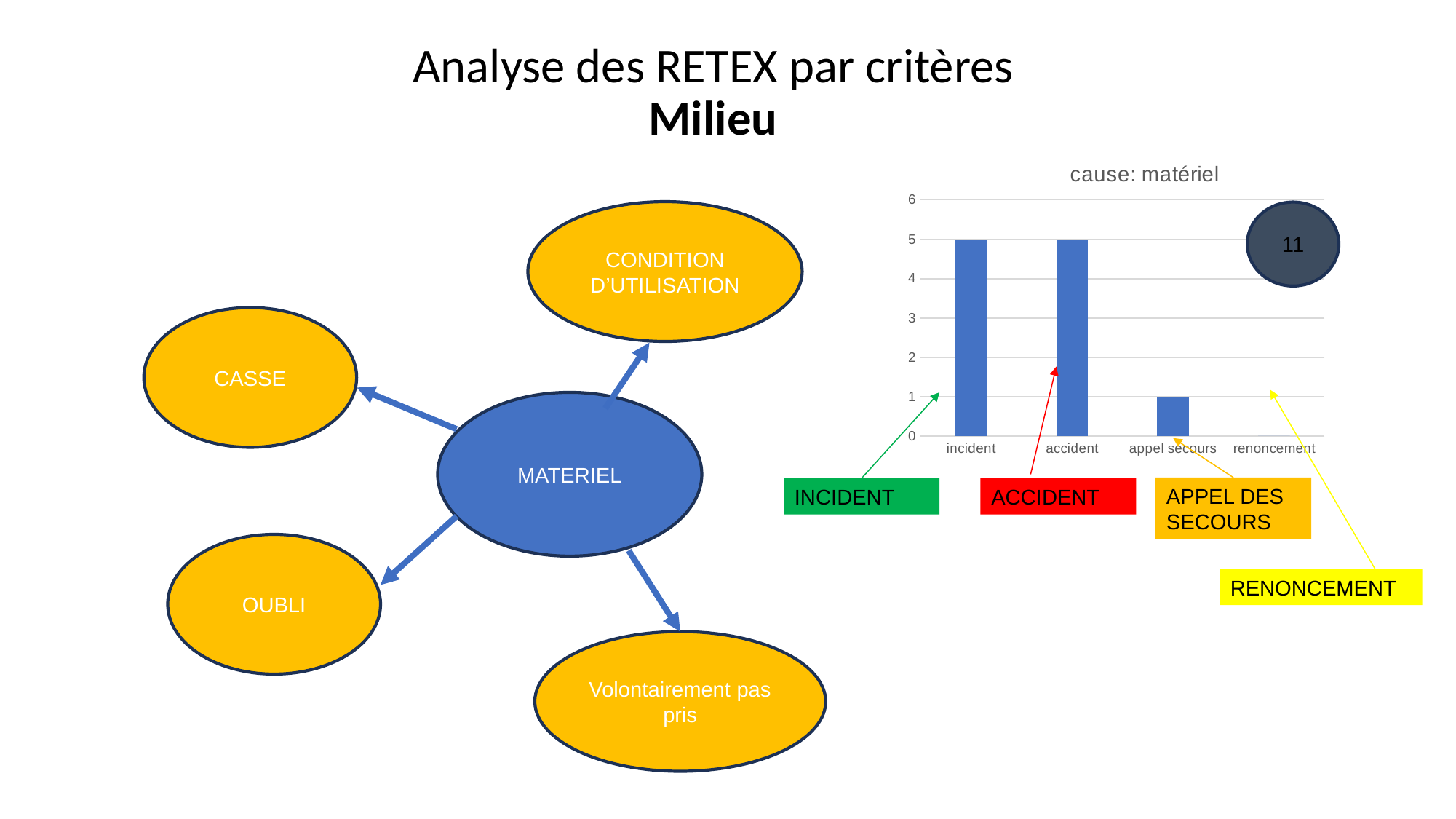
What is the value for incident in the chart? 5 Is the value for appel secours greater or less than 2? less What is the difference between the values for incident and appel secours? 4 What is the value for accident in the chart? 5 What is the value for renoncement in the chart? 0 What is the value for appel secours in the chart? 1 What is the title of the chart? cause: matériel Which is larger, the value for accident or the value for appel secours? accident How many categories are shown on the x axis of the chart? 4 Which category has the lowest value in the chart? renoncement Is the value for incident greater or less than 3? greater What kind of chart is shown on the slide? bar chart